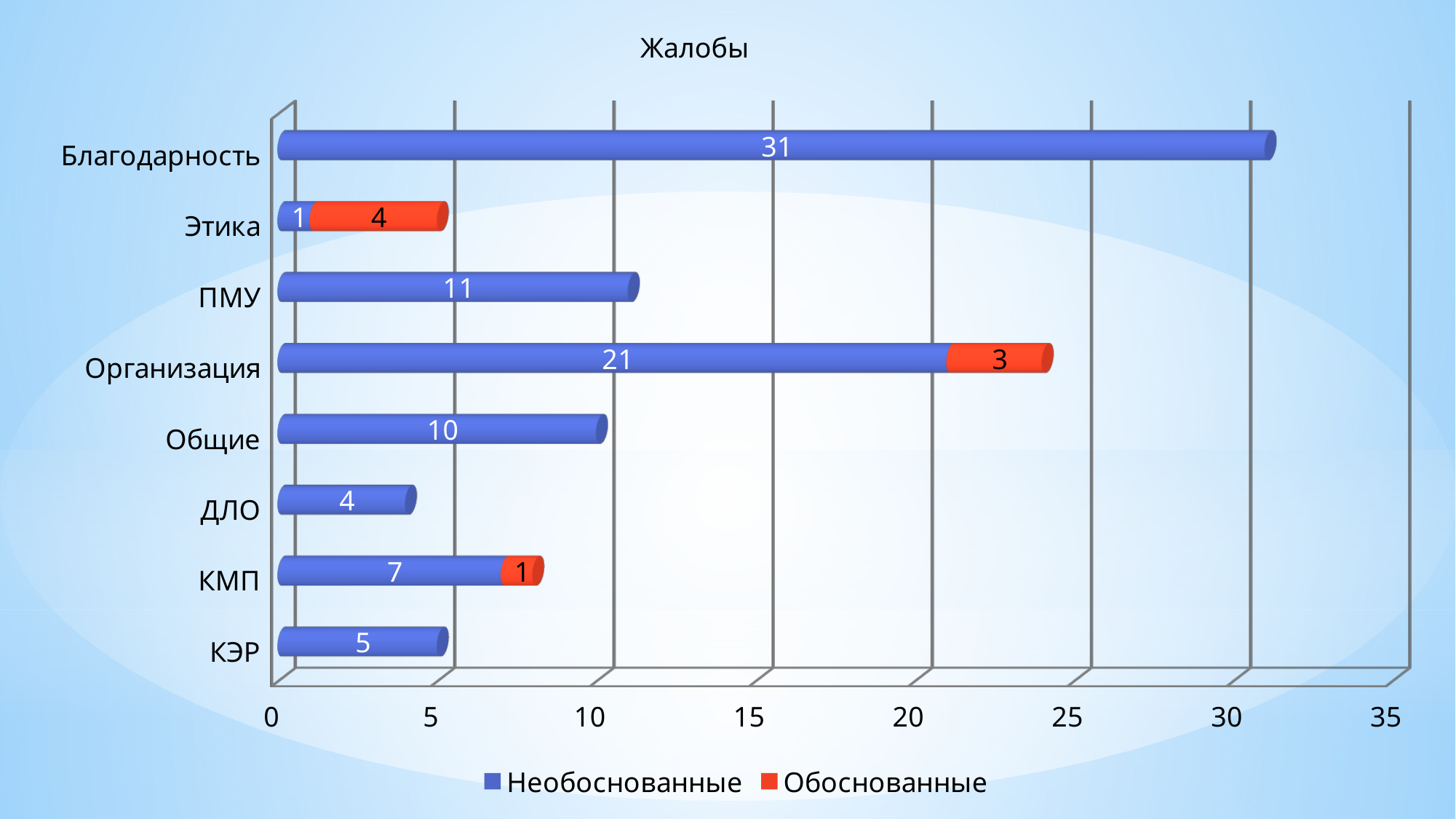
What type of chart is shown on the slide? bar chart What is the value of Необоснованные for Организация? 21 Which category has the highest value of Необоснованные? Благодарность What is the title of the chart? Жалобы What is the value of Необоснованные for Благодарность? 31 What is the total of the stacked bar for Организация? 24 What is the difference between the Необоснованные values for ПМУ and Общие? 1 What is the value of Обоснованные for Этика? 4 Which category has the lowest value of Необоснованные? Этика How many series does the legend list? 2 Which is larger, the Необоснованные value for КМП or for КЭР? КМП How many categories are shown on the chart? 8